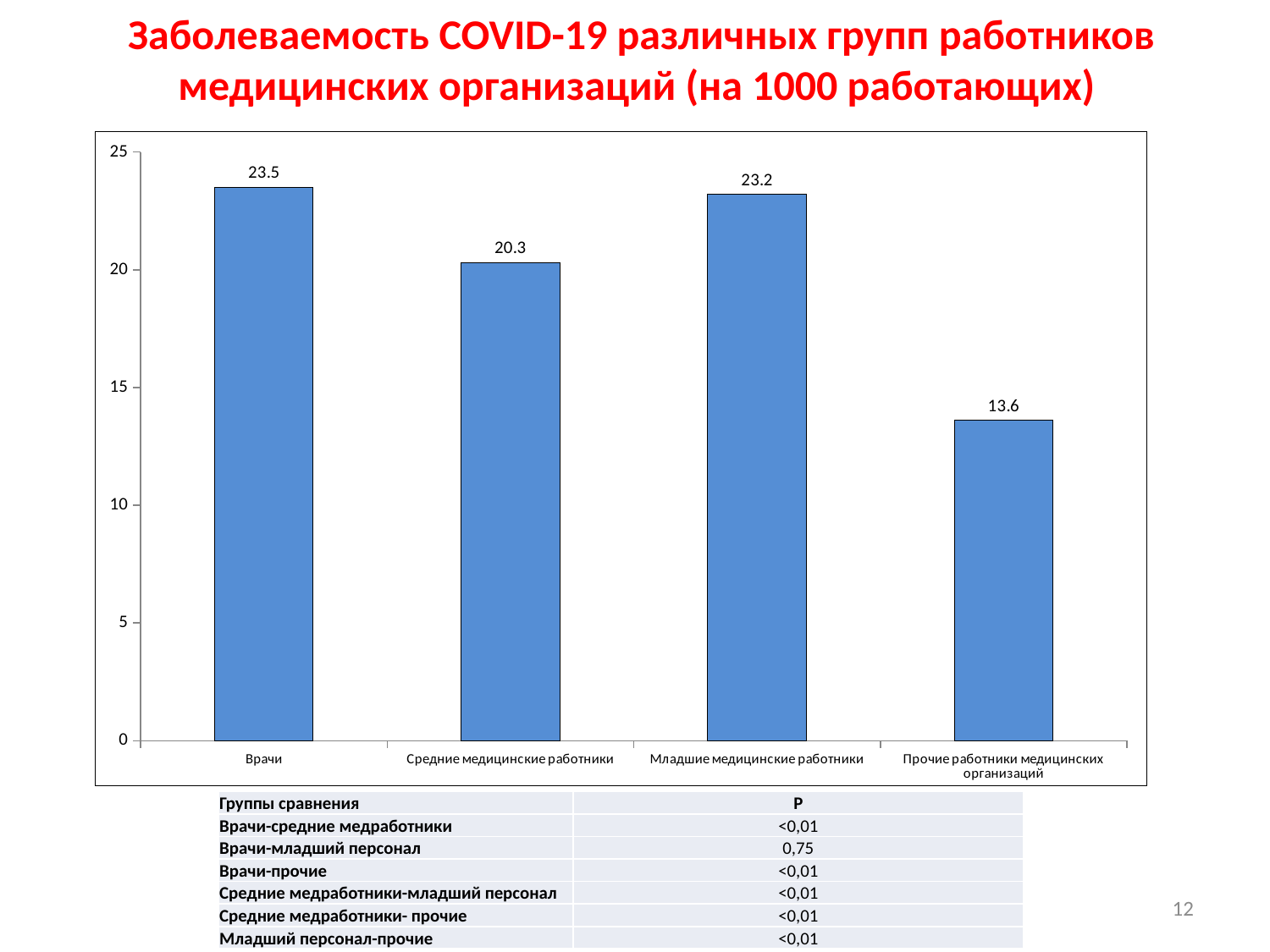
Is the value for Прочие работники медицинских организаций greater or less than 15? less Which group has the highest incidence value? Врачи How many groups of workers are shown in the chart? 4 What is the difference between the values for Врачи and Прочие работники медицинских организаций? 9.9 Which group has the lowest incidence value? Прочие работники медицинских организаций What is the COVID-19 incidence value for Врачи? 23.5 Which is larger, the value for Средние медицинские работники or the value for Прочие работники медицинских организаций? Средние медицинские работники What is the value shown for Прочие работники медицинских организаций? 13.6 What is the value shown for Средние медицинские работники? 20.3 What is the value shown for Младшие медицинские работники? 23.2 What is the difference between the values for Средние медицинские работники and Прочие работники медицинских организаций? 6.7 What type of chart is shown on the slide? bar chart